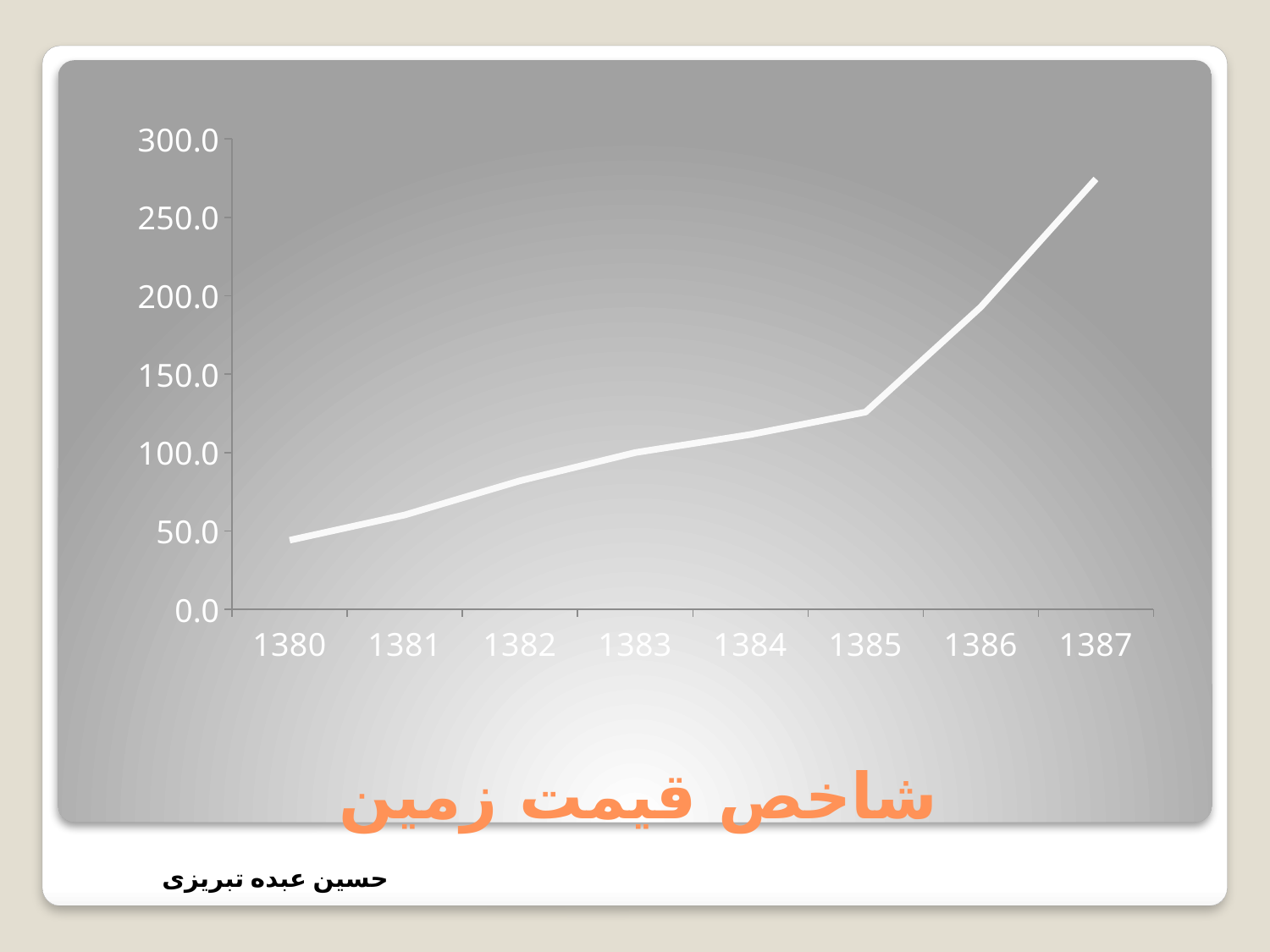
Which year has the larger value, 1385 or 1386? 1386 Which year has the highest value on the line? 1387 Is the value for 1386 greater or less than 150.0? greater Is the value for 1383 greater or less than 150.0? less How many years are plotted along the x axis? 8 Is the value for 1380 greater or less than 50.0? less What kind of chart is shown on the slide? line chart Which year has the lowest value on the line? 1380 Which year has the larger value, 1381 or 1384? 1384 Do the values rise or fall from 1380 to 1387? rise What is the title shown below the chart? شاخص قیمت زمین